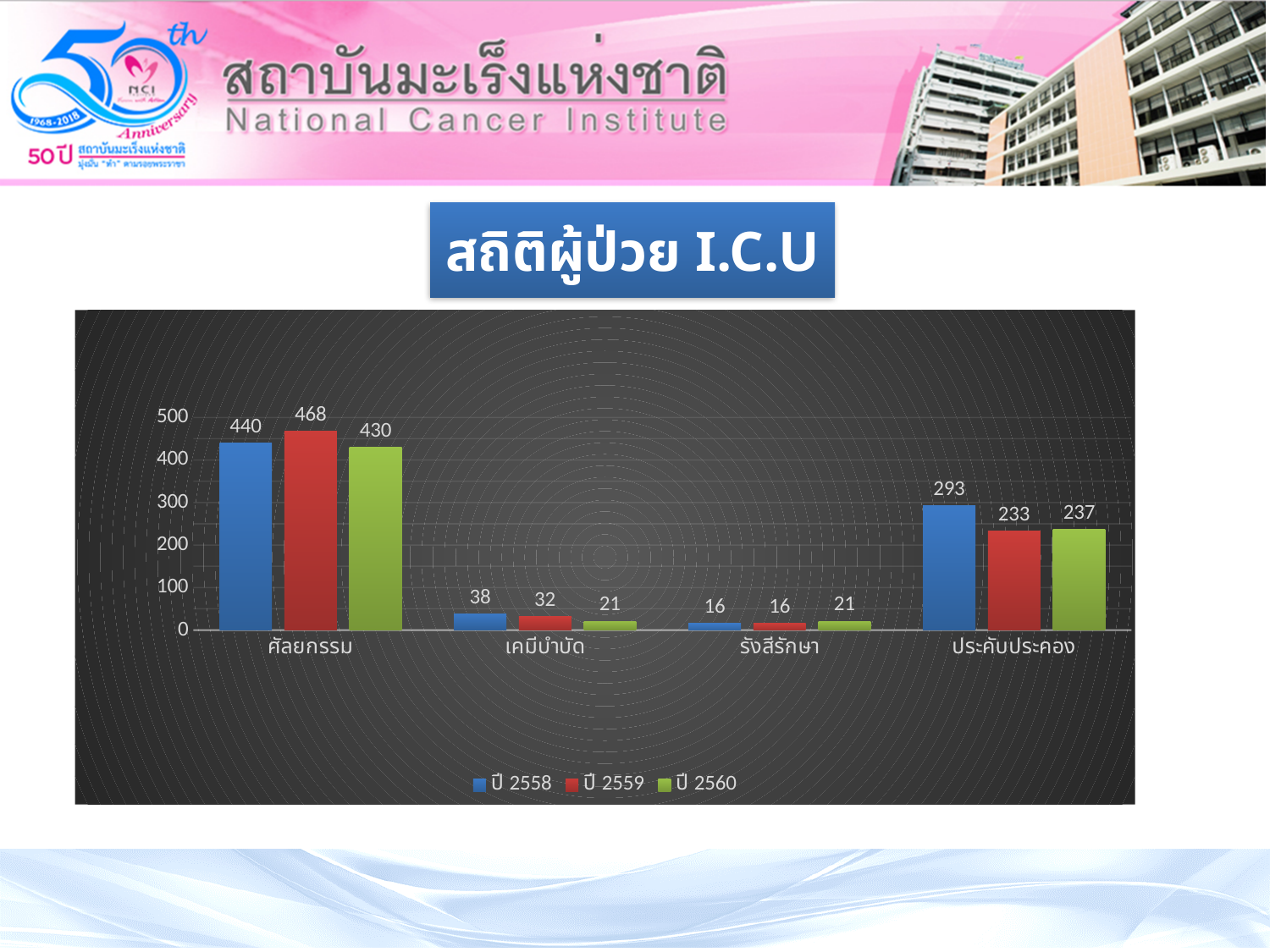
What is the value for ศัลยกรรม in ปี 2559? 468 What is the difference between the ปี 2559 and ปี 2558 values for ศัลยกรรม? 28 What is the title of the chart? สถิติผู้ป่วย I.C.U Is the value for ประคับประคอง in ปี 2560 greater or less than 200? greater Which category has the lowest value in ปี 2558? รังสีรักษา What is the value for เคมีบำบัด in ปี 2560? 21 Which is larger for ประคับประคอง: the value in ปี 2558 or in ปี 2559? ปี 2558 What type of chart is shown on the slide? bar chart Which category has the highest value in ปี 2560? ศัลยกรรม How many series does the legend list? 3 How many categories are shown on the x axis? 4 What is the value for ประคับประคอง in ปี 2558? 293